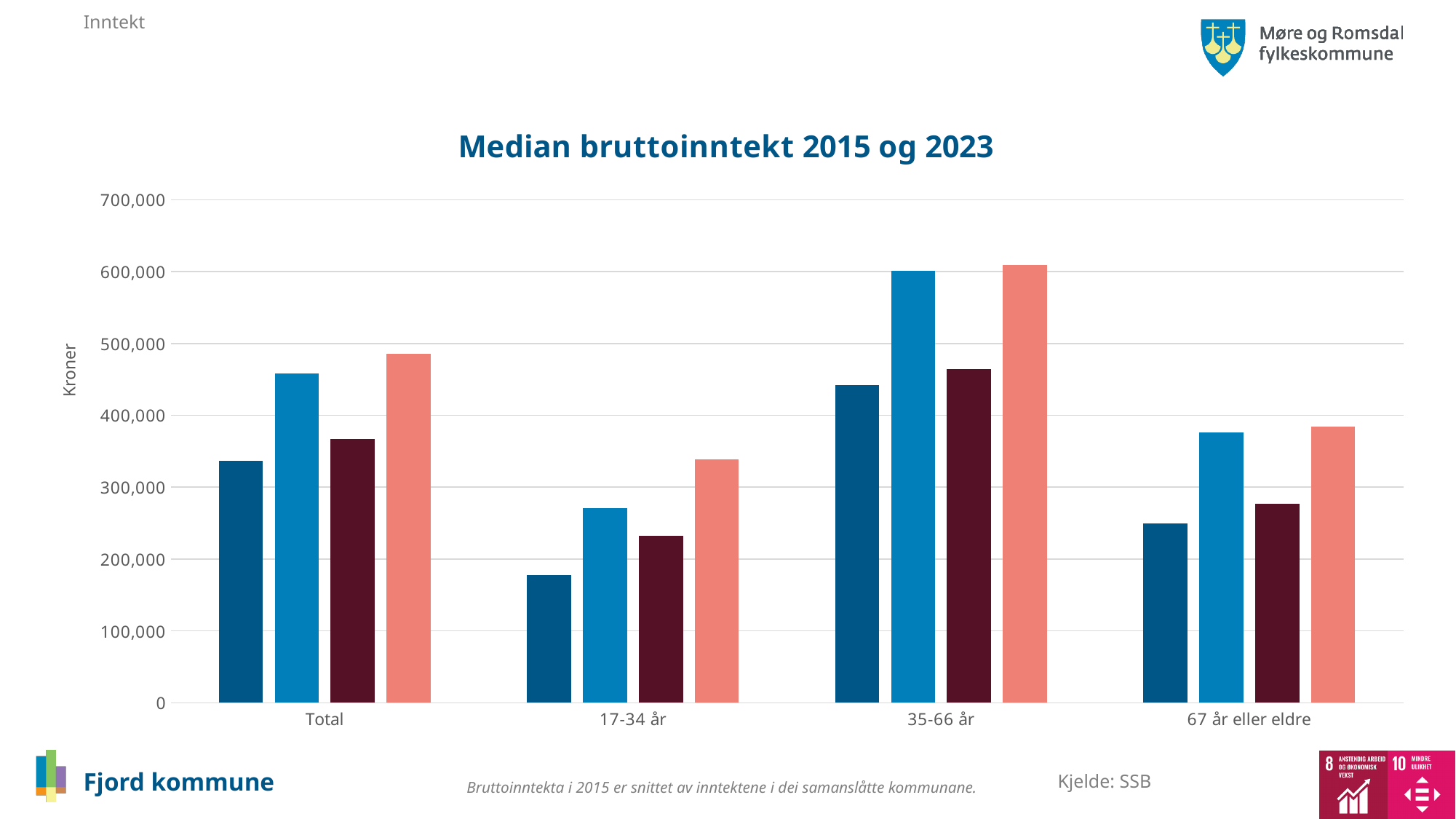
Is the value of the first (dark blue) bar for 17-34 år greater or less than 200,000? less What kind of chart is shown on the slide? bar chart Which category contains the shortest bar in the chart? 17-34 år Which category contains the tallest bar in the chart? 35-66 år How many bars are plotted for each category in the chart? 4 Is the value of the fourth (salmon) bar for Total greater or less than 400,000? greater Is the value of the second (light blue) bar for 35-66 år greater or less than 500,000? greater Which is larger: the first (dark blue) bar for Total or the first (dark blue) bar for 67 år eller eldre? Total How many categories are shown along the x axis of the chart? 4 What is the label on the vertical axis of the chart? Kroner What is the title of the chart? Median bruttoinntekt 2015 og 2023